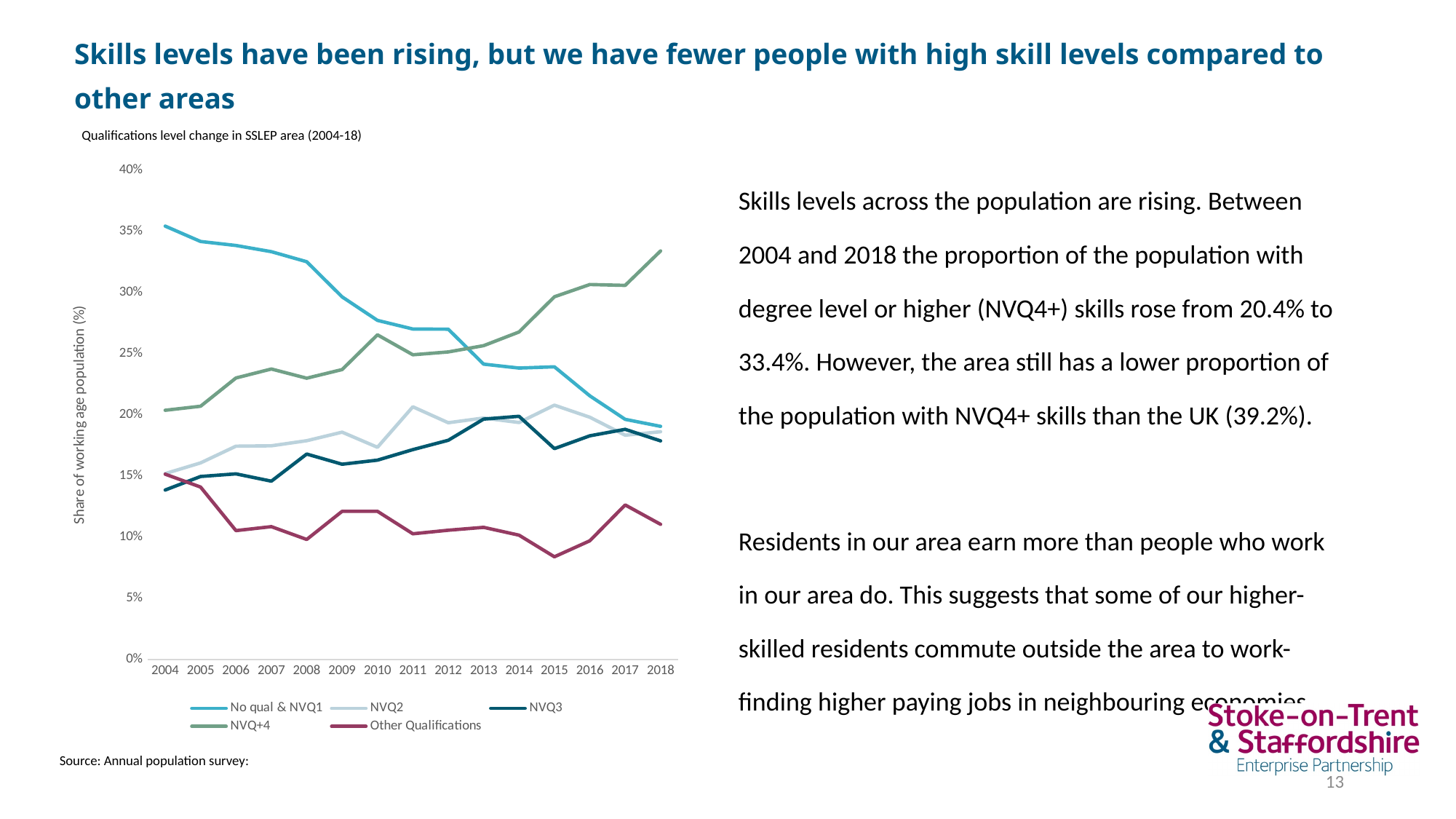
How many years are plotted along the x axis of the chart? 15 In 2004, which is larger: the value for NVQ+4 or the value for NVQ2? NVQ+4 Does the No qual & NVQ1 line rise or fall from 2004 to 2018? Fall Does the NVQ+4 line rise or fall from 2004 to 2018? Rise Which series has the lowest value in 2018? Other Qualifications Which series has the highest value in 2004? No qual & NVQ1 Is the value for No qual & NVQ1 in 2004 greater or less than 30%? greater What is the title of the chart? Qualifications level change in SSLEP area (2004-18) Is the value for Other Qualifications in 2015 greater or less than 10%? less What kind of chart is shown on the slide? Line chart Which series has the highest value in 2018? NVQ+4 How many series does the chart legend list? 5